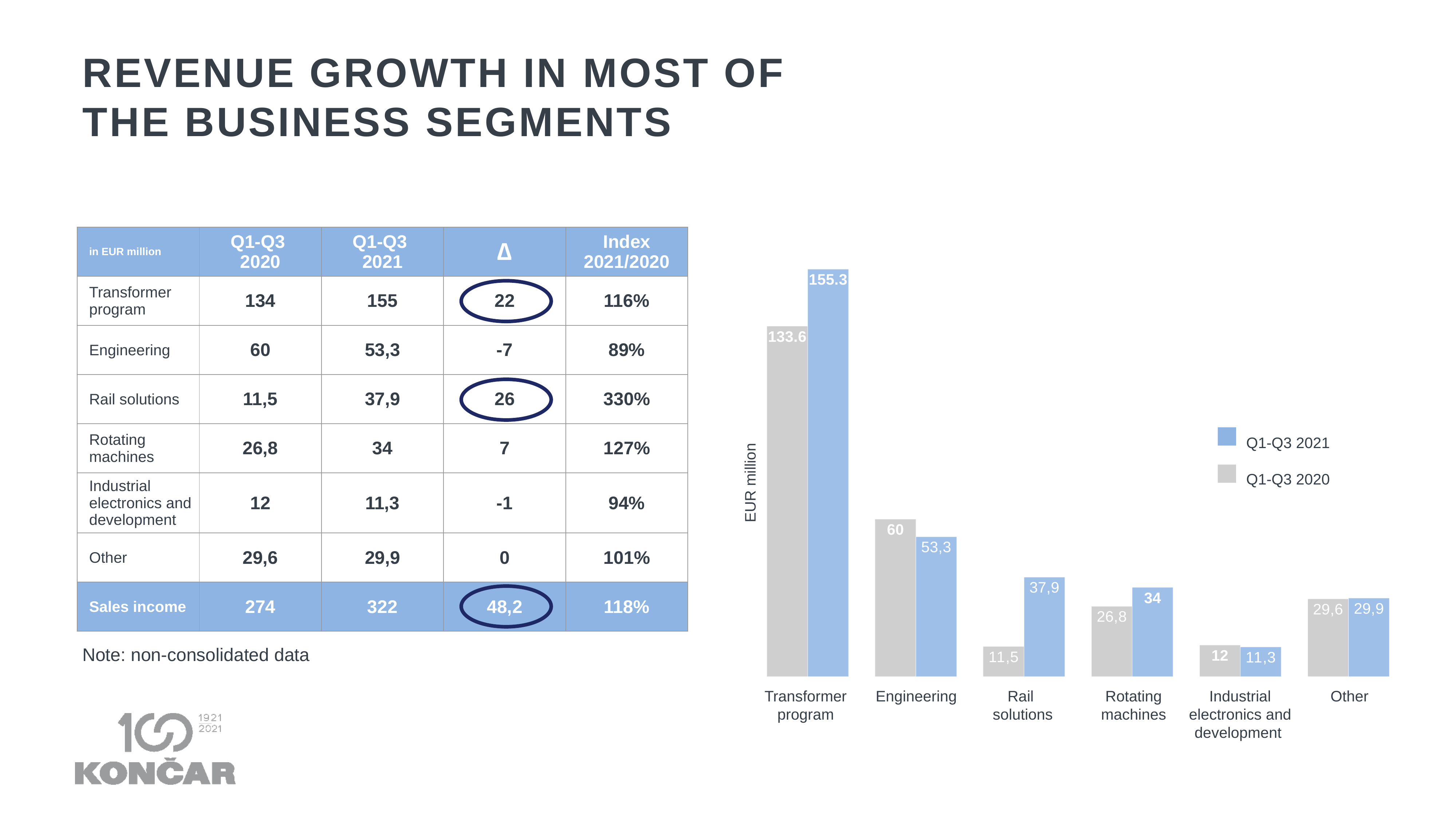
What is the Q1-Q3 2020 value for Industrial electronics and development in the chart? 12 For Engineering, which is larger in the chart: the Q1-Q3 2020 value or the Q1-Q3 2021 value? Q1-Q3 2020 Which segment has the highest Q1-Q3 2021 value in the chart? Transformer program Which segment has the lowest Q1-Q3 2020 value in the chart? Rail solutions How many business segments are shown on the x axis of the chart? 6 What is the Q1-Q3 2021 value for Rotating machines in the chart? 34 What is the difference between the Q1-Q3 2021 and Q1-Q3 2020 values for Rail solutions in the chart? 26,4 What is the Q1-Q3 2021 value for Transformer program in the chart? 155.3 What unit is shown on the vertical axis label of the chart? EUR million What is the Q1-Q3 2020 value for Rail solutions in the chart? 11,5 What kind of chart is shown on the slide? bar chart How many series does the chart legend list? 2